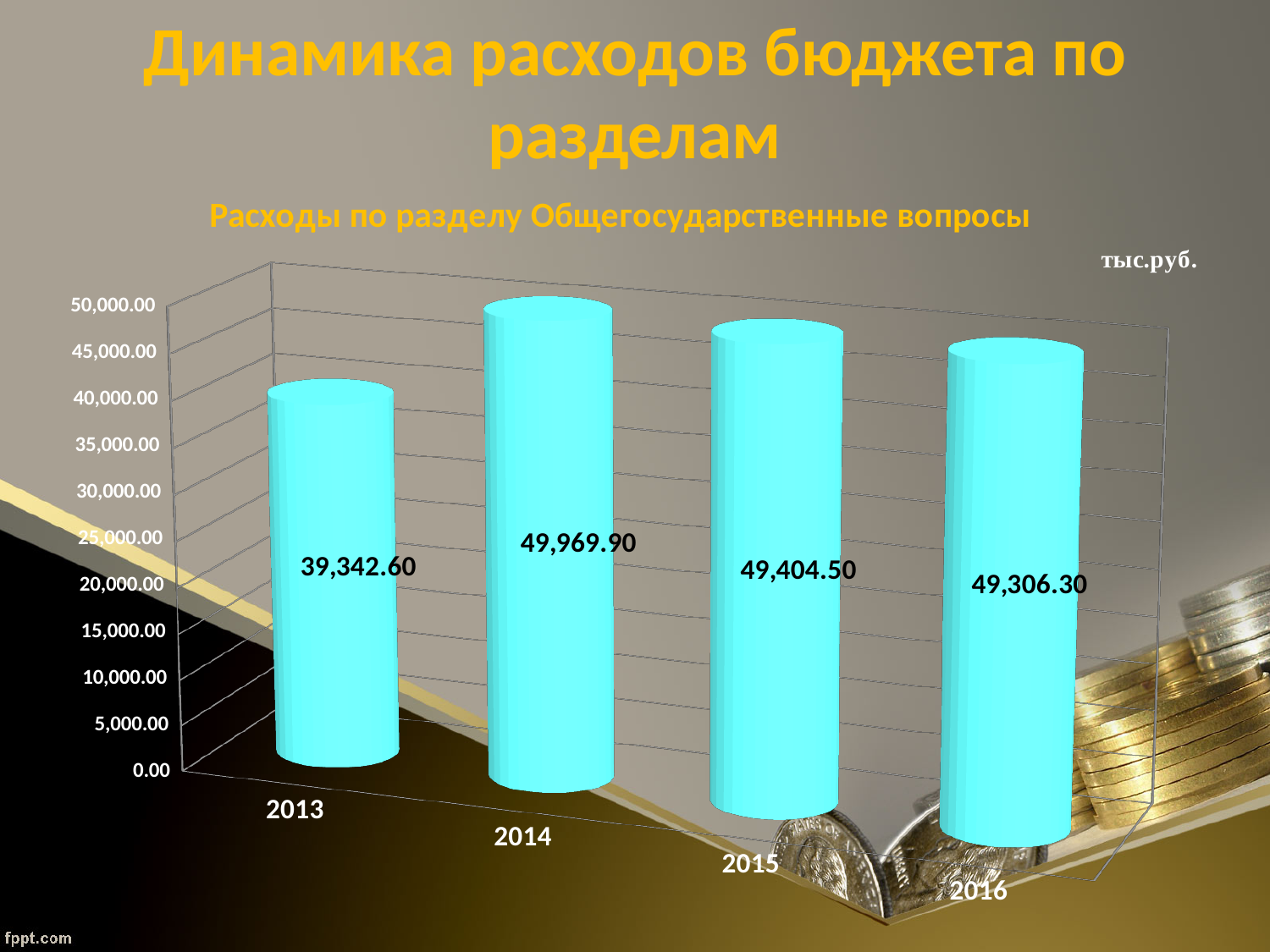
Which is larger, the value for 2013 or the value for 2015? 2015 What is the difference between the values for 2014 and 2013? 10,627.30 What is the value for 2014? 49,969.90 How many years are shown on the chart? 4 Which year has the highest value? 2014 Is the value for 2013 greater or less than 40,000.00? less What kind of chart is shown on the slide? bar chart Which year has the lowest value? 2013 What unit of measurement is indicated on the chart? тыс.руб. What is the difference between the values for 2014 and 2015? 565.40 What is the value for 2016? 49,306.30 What is the value for 2013? 39,342.60